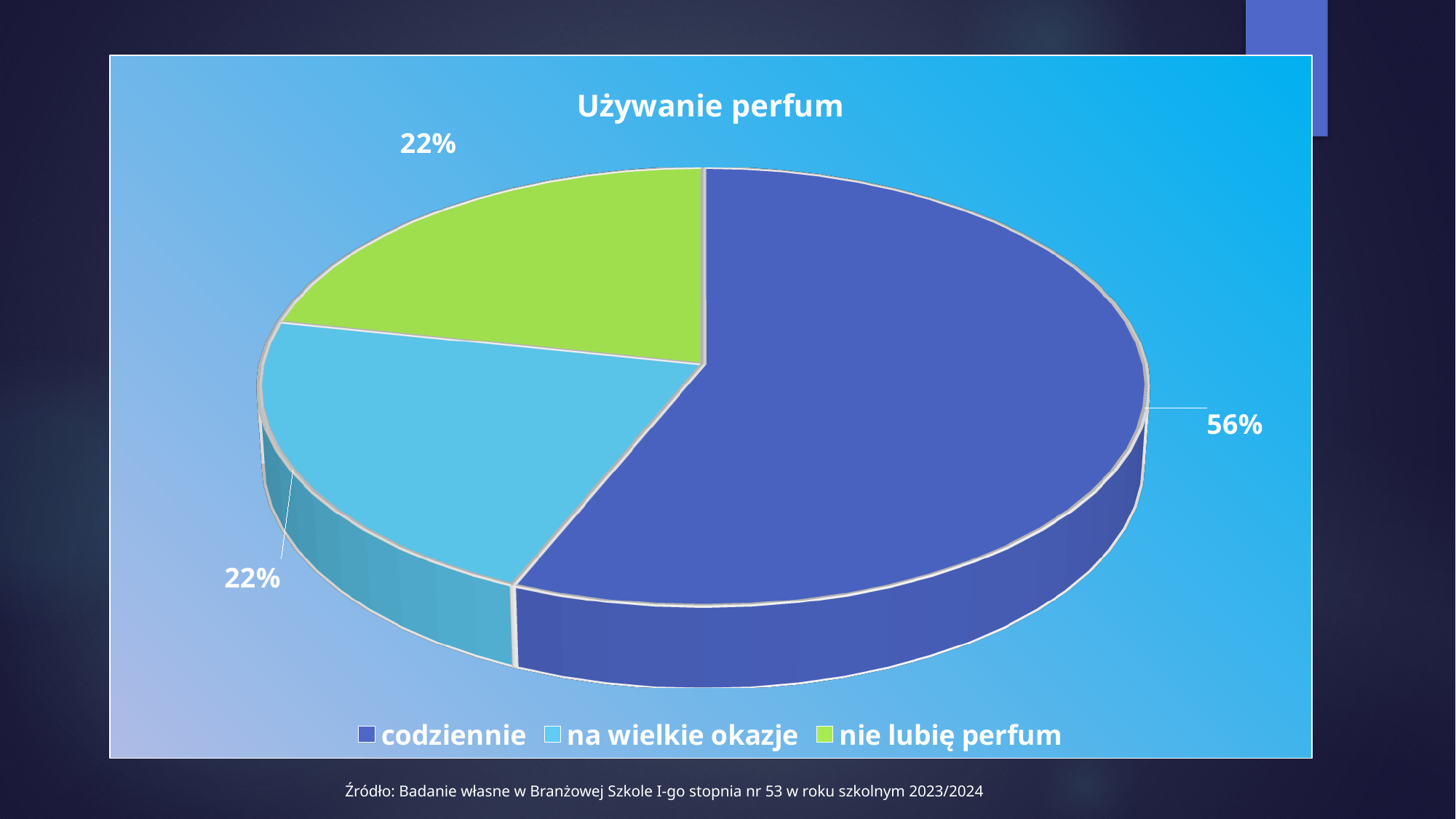
Which legend entry is shown in green? nie lubię perfum What is the title of the chart? Używanie perfum Which category has the largest slice of the pie? codziennie What is the difference in percentage points between "codziennie" and "na wielkie okazje"? 34 What kind of chart is shown on the slide? pie chart What percentage of the pie is labelled "na wielkie okazje"? 22% How many entries does the legend list? 3 What percentage of the pie is labelled "nie lubię perfum"? 22% How many slices does the pie chart have? 3 What percentage of the pie is labelled "codziennie"? 56% Which is larger, the slice for "codziennie" or the slice for "nie lubię perfum"? codziennie What share of the pie does the "codziennie" slice represent? 56%